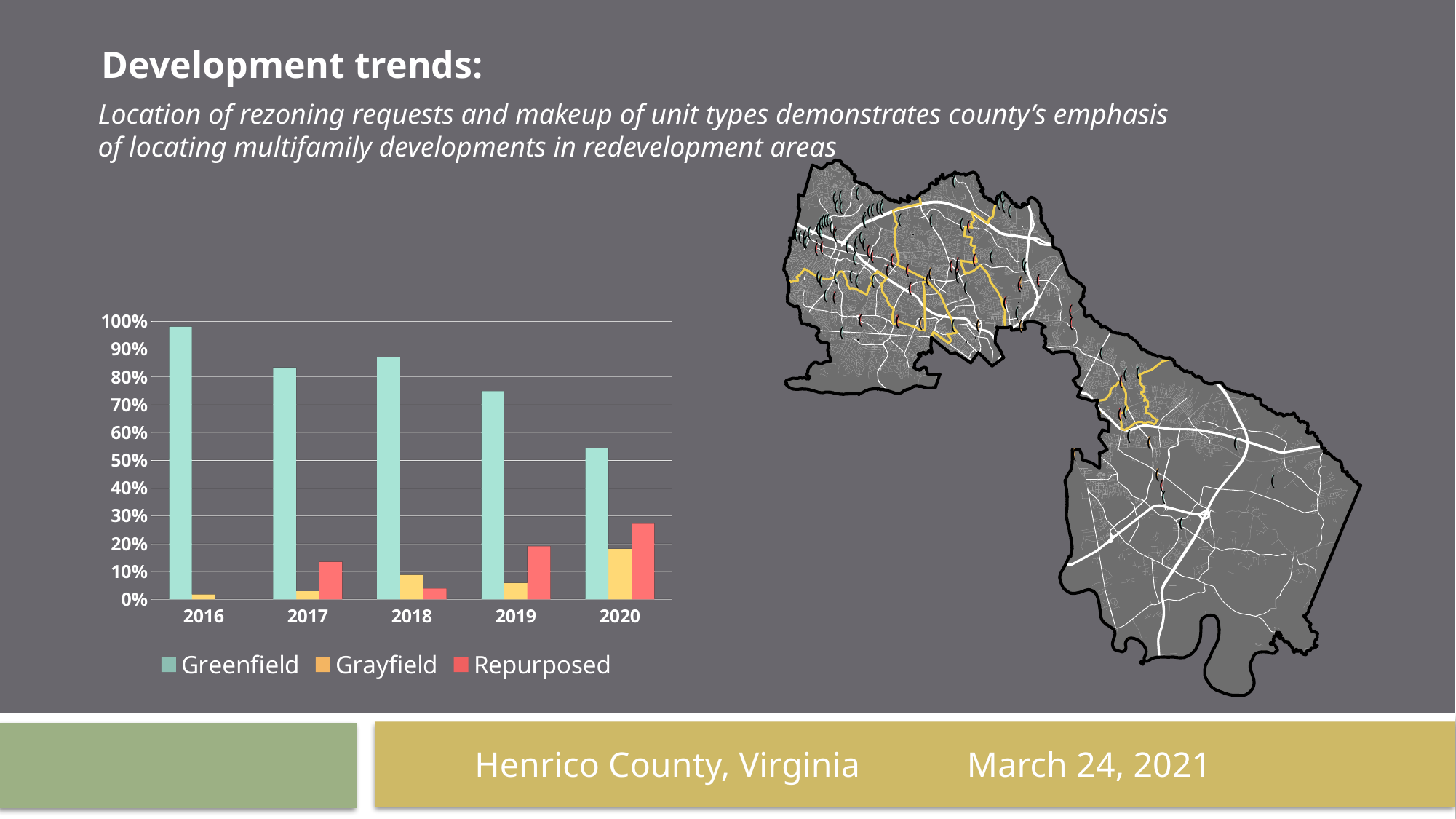
Which year has the highest Grayfield value? 2020 What kind of chart is shown on the slide? bar chart What are the three series named in the chart legend? Greenfield, Grayfield, Repurposed How many series does the chart legend list? 3 Is the Repurposed value for 2020 greater or less than 20%? greater How many years are shown on the x axis of the chart? 5 Is the Greenfield value for 2016 greater or less than 90%? greater Which year has the highest Repurposed value? 2020 In 2019, which is larger: the Grayfield value or the Repurposed value? Repurposed Which year has the lowest Greenfield value? 2020 Which year has the highest Greenfield value? 2016 Is the Greenfield value for 2020 greater or less than 60%? less